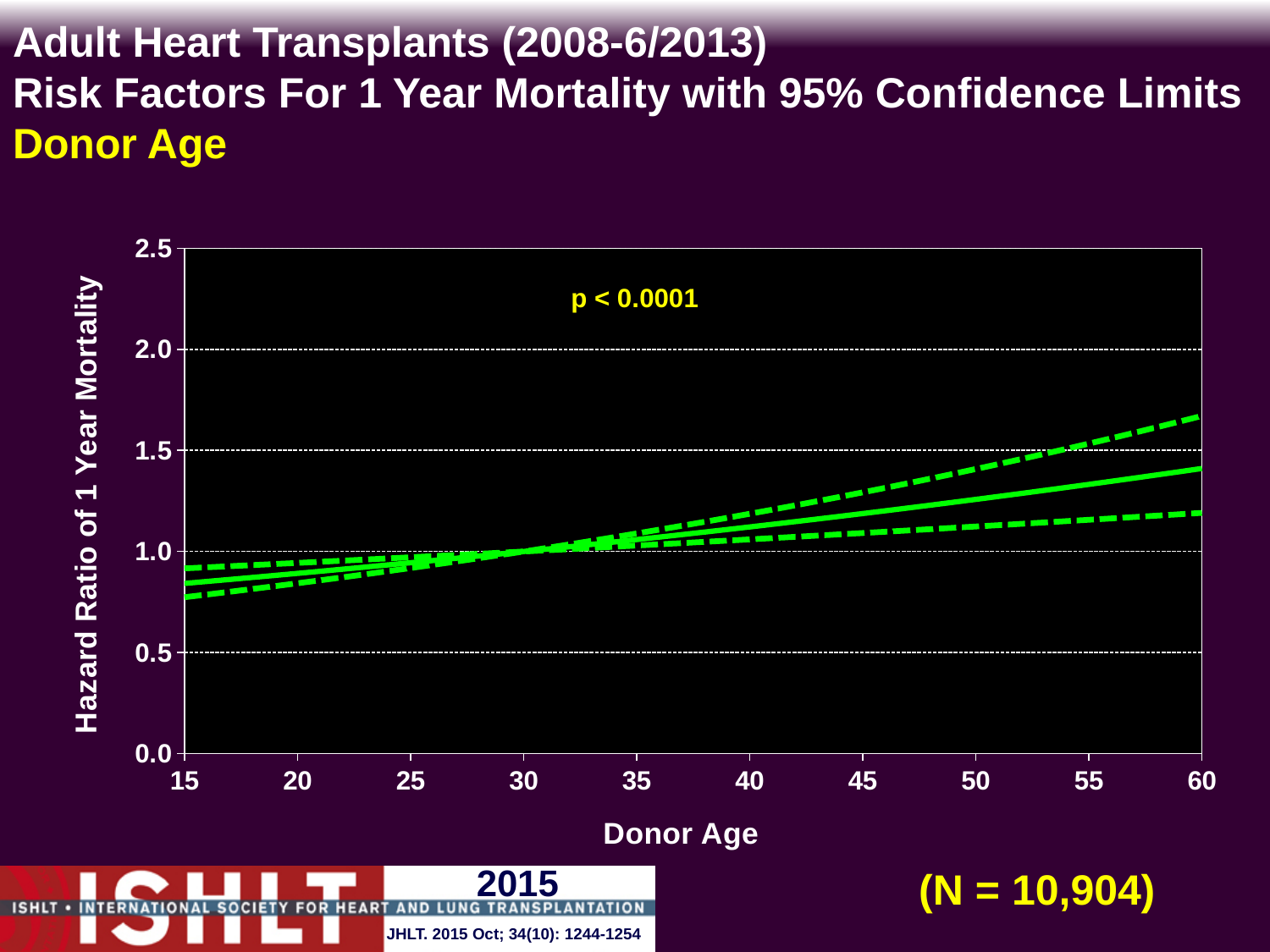
Does the hazard ratio of 1 year mortality rise or fall as donor age increases from 15 to 60? rise What p-value is printed on the chart? p < 0.0001 Which donor age has the larger hazard ratio on the solid line, 15 or 60? 60 At which donor age shown on the x axis is the hazard ratio (solid line) highest? 60 Is the upper 95% confidence limit (upper dashed line) at donor age 60 greater or less than 1.5? greater Is the hazard ratio (solid line) at donor age 45 greater or less than 1.5? less Is the hazard ratio (solid line) at donor age 60 greater or less than 1.0? greater What kind of chart is shown on the slide? line chart What is the N (sample size) shown on the slide? N = 10,904